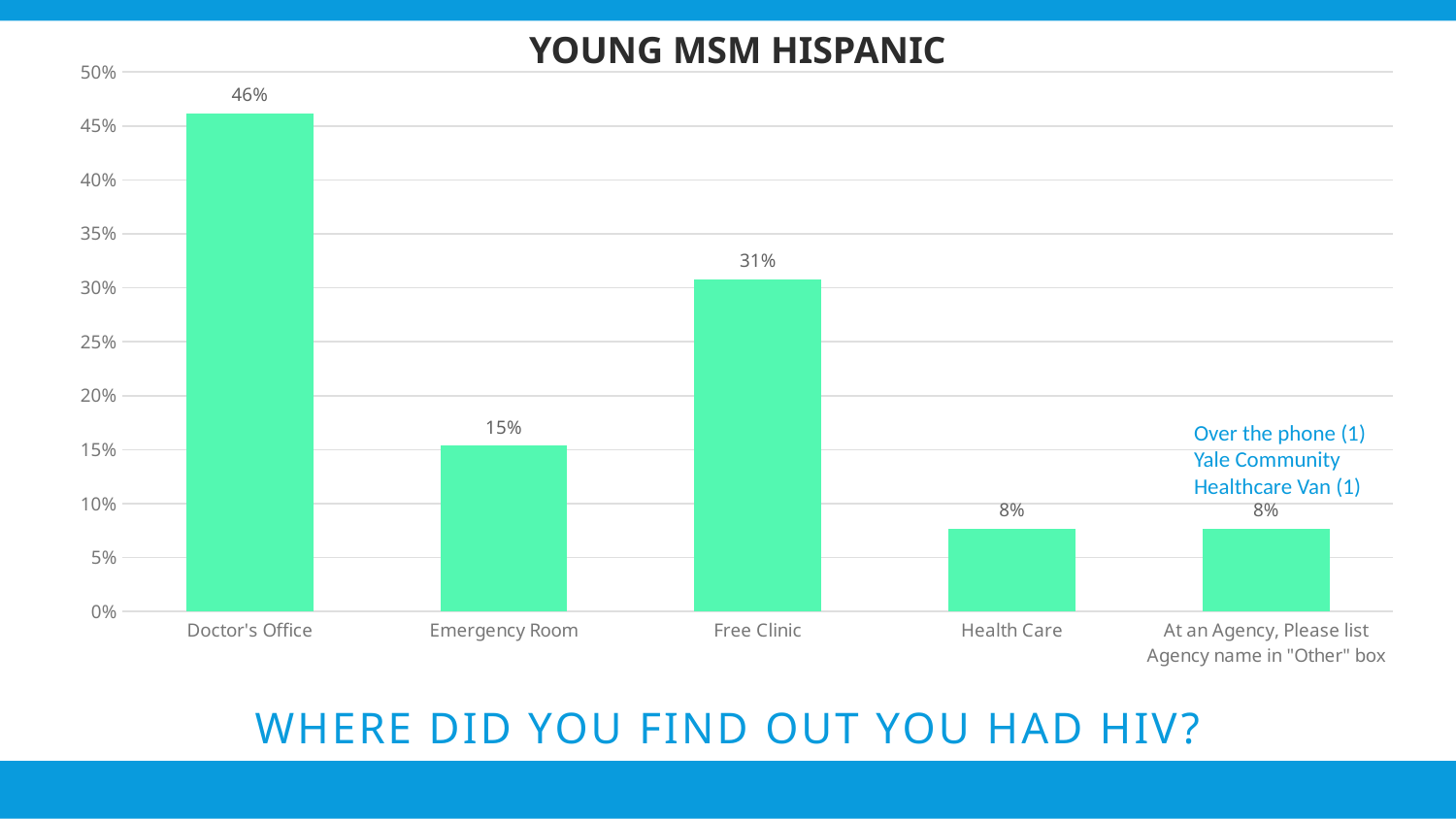
What is the value for Doctor's Office? 46% What is the value for Emergency Room? 15% What is the difference between the values for Free Clinic and Emergency Room? 16% What is the difference between the values for Doctor's Office and Free Clinic? 15% What kind of chart is shown on the slide? bar chart Which is larger, the value for Emergency Room or the value for Free Clinic? Free Clinic What is the value for Free Clinic? 31% What is the title of the chart? YOUNG MSM HISPANIC What is the value for Health Care? 8% Is the value for Emergency Room greater or less than 20%? less Which category has the highest value? Doctor's Office How many categories are shown on the x axis? 5